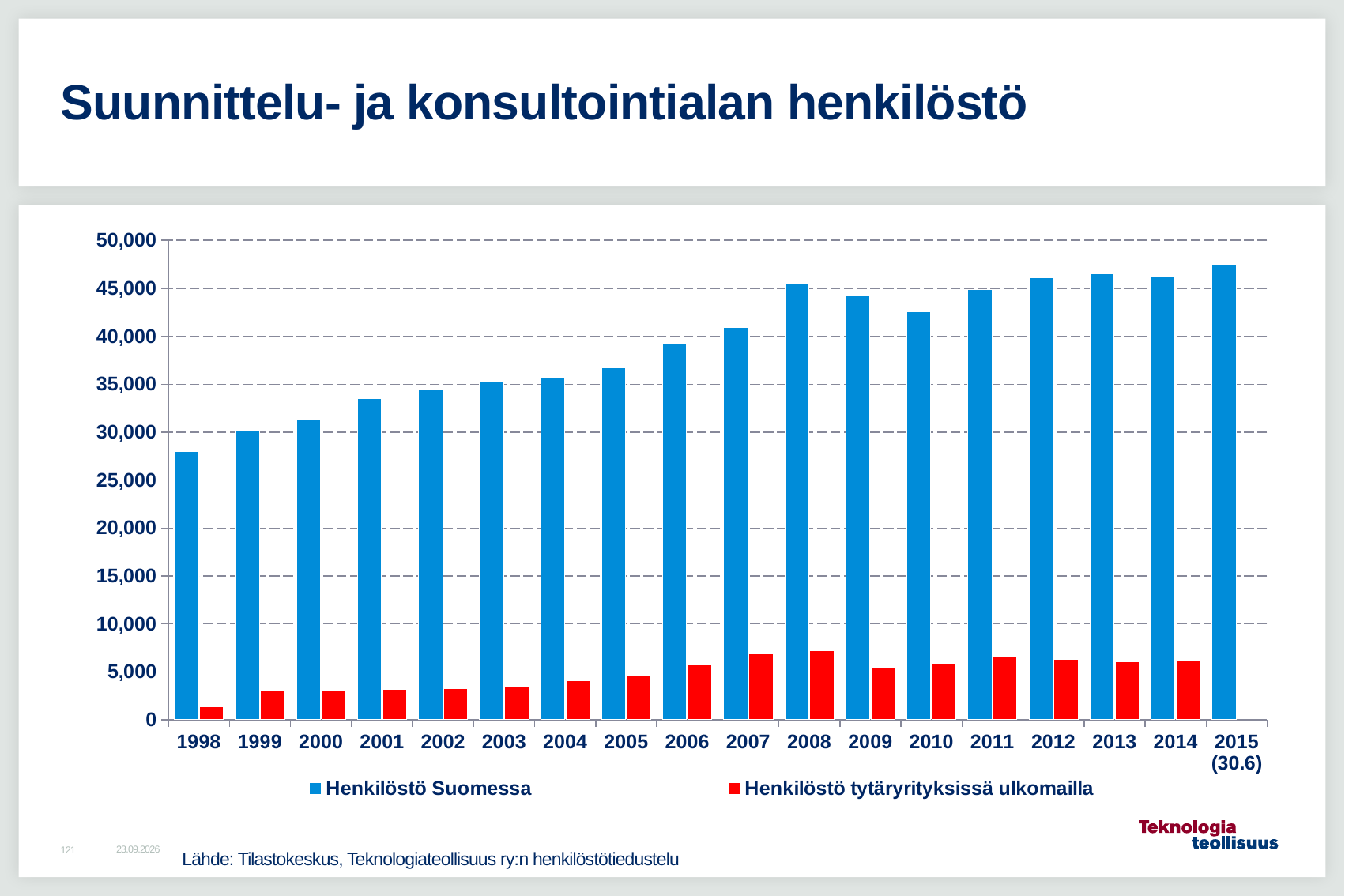
What kind of chart is shown on the slide? bar chart How many series does the legend list? 2 Which year has the highest value for Henkilöstö Suomessa? 2015 (30.6) Is the value for Henkilöstö Suomessa in 1998 greater or less than 25,000? greater How many years are shown on the x axis? 18 Is the value for Henkilöstö tytäryrityksissä ulkomailla in 1999 greater or less than 5,000? less Is the value for Henkilöstö Suomessa in 2010 greater or less than 40,000? greater Does Henkilöstö Suomessa generally rise or fall from 1998 to 2015? rise Which year has the lowest value for Henkilöstö tytäryrityksissä ulkomailla? 1998 Which year has the lowest value for Henkilöstö Suomessa? 1998 Which is larger, Henkilöstö Suomessa in 2009 or in 2010? 2009